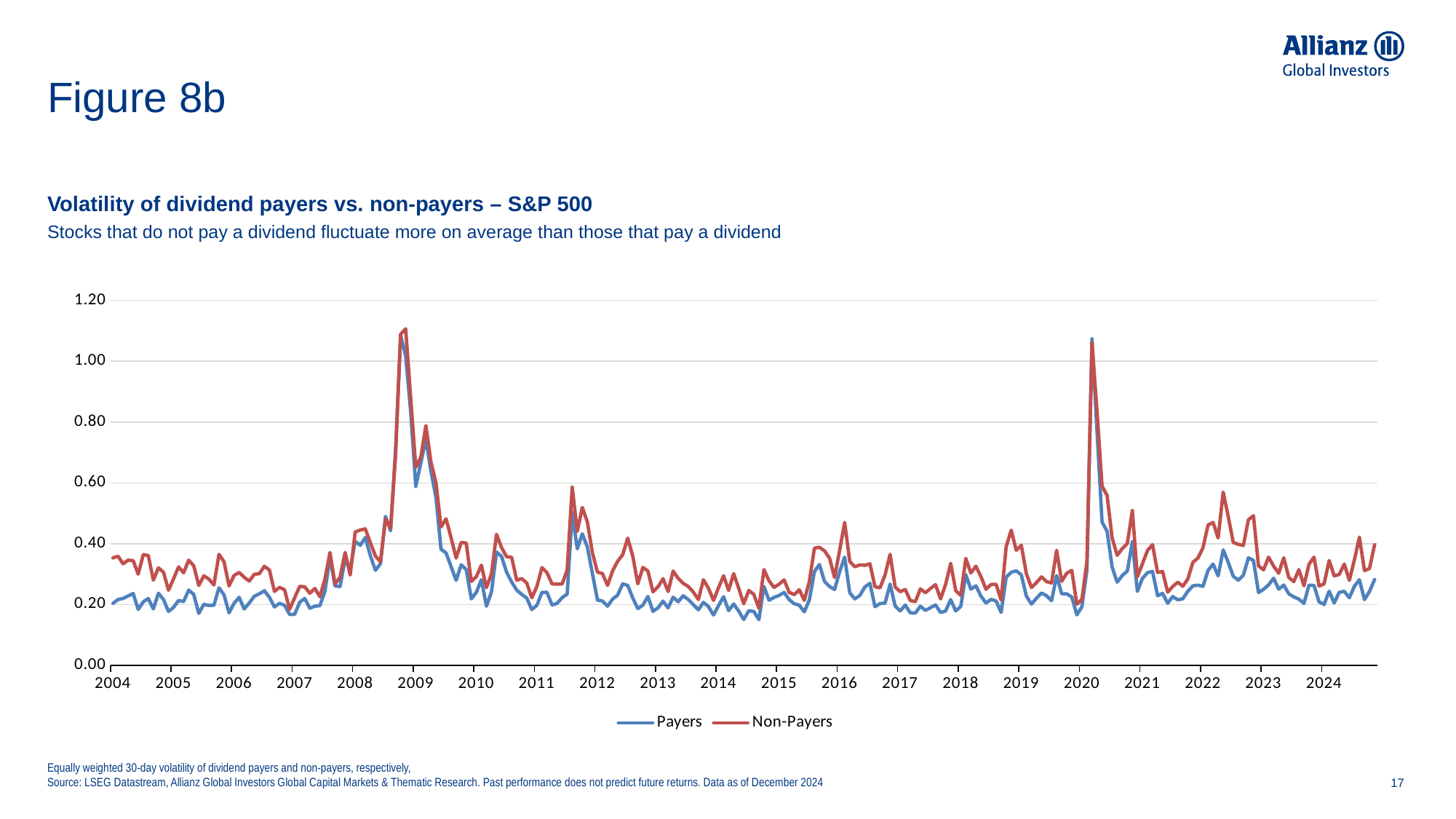
Between the 2009 peak and 2014, do the Payers values generally rise or fall? fall Is the value of the Payers line at the start of 2004 greater or less than 0.40? less Is the peak of the Non-Payers line in 2022 greater or less than 0.40? greater Is the peak value of the Payers line around 2020 greater or less than 1.00? greater Which series is generally higher across the chart, Payers or Non-Payers? Non-Payers How many series does the legend list? 2 Which colour is used for the Non-Payers line? red What kind of chart is shown on the slide? line chart What is the title of the chart? Volatility of dividend payers vs. non-payers – S&P 500 At the 2022 peak, which series has the larger value, Payers or Non-Payers? Non-Payers Does the highest peak on the chart occur around 2008–2009 or around 2020? 2008–2009